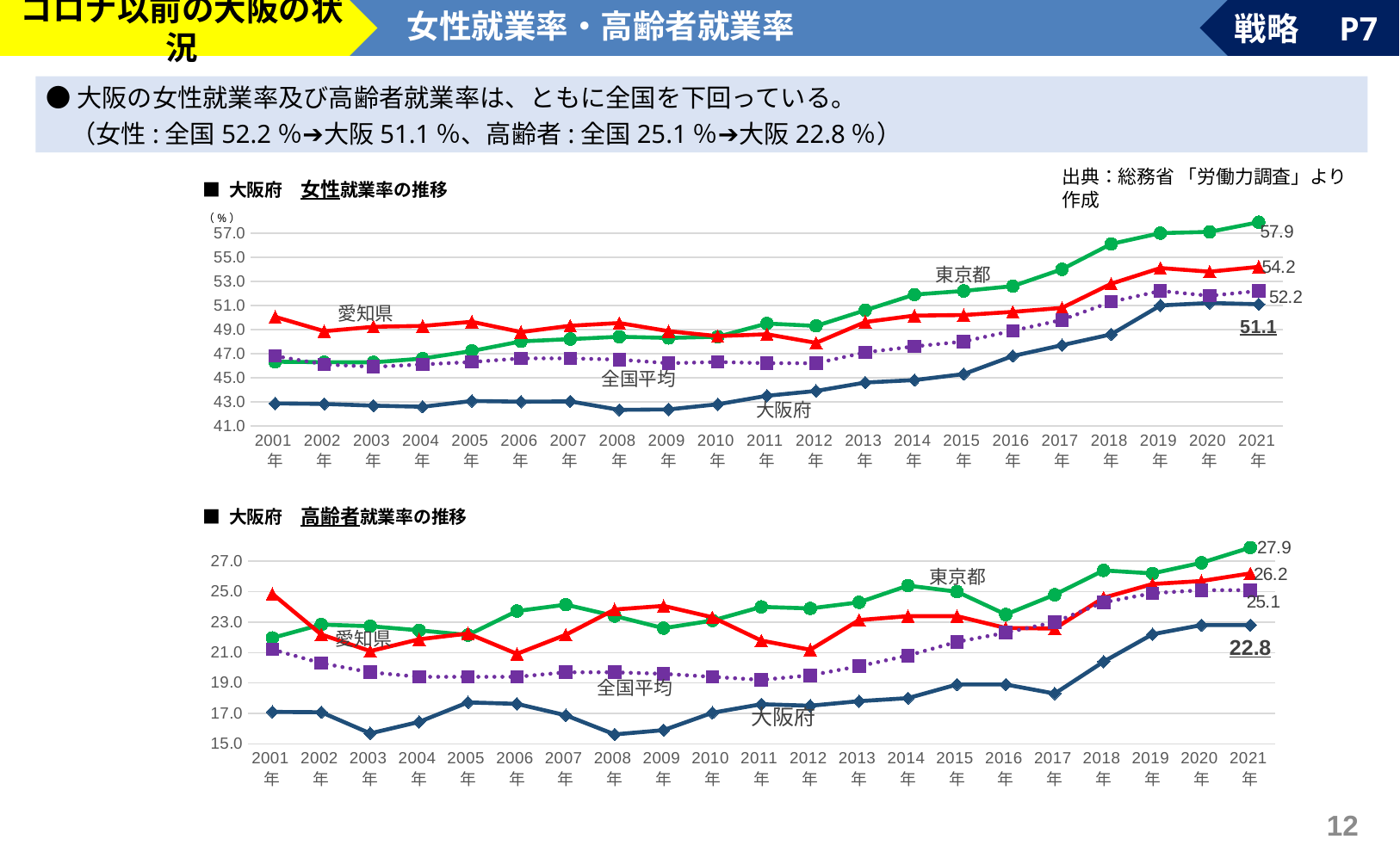
In the bottom chart (高齢者就業率の推移), what is the 2021 value for 大阪府? 22.8 In the bottom chart (高齢者就業率の推移), which series has the lowest value in 2021? 大阪府 In the top chart (女性就業率の推移), what is the 2021 value for 東京都? 57.9 In the top chart (女性就業率の推移), what is the difference between the 2021 values for 全国平均 and 大阪府? 1.1 What kind of chart is the bottom chart (高齢者就業率の推移)? line chart In the top chart (女性就業率の推移), what is the 2021 value for 全国平均? 52.2 How many years are plotted on the x axis of the top chart (女性就業率の推移)? 21 In the bottom chart (高齢者就業率の推移), what is the 2021 value for 愛知県? 26.2 In the top chart (女性就業率の推移), what is the 2021 value for 大阪府? 51.1 In the bottom chart (高齢者就業率の推移), is the value for 大阪府 in 2001 greater or less than 19.0? less In the bottom chart (高齢者就業率の推移), what is the difference between the 2021 values for 東京都 and 全国平均? 2.8 In the top chart (女性就業率の推移), which series has the highest value in 2021? 東京都